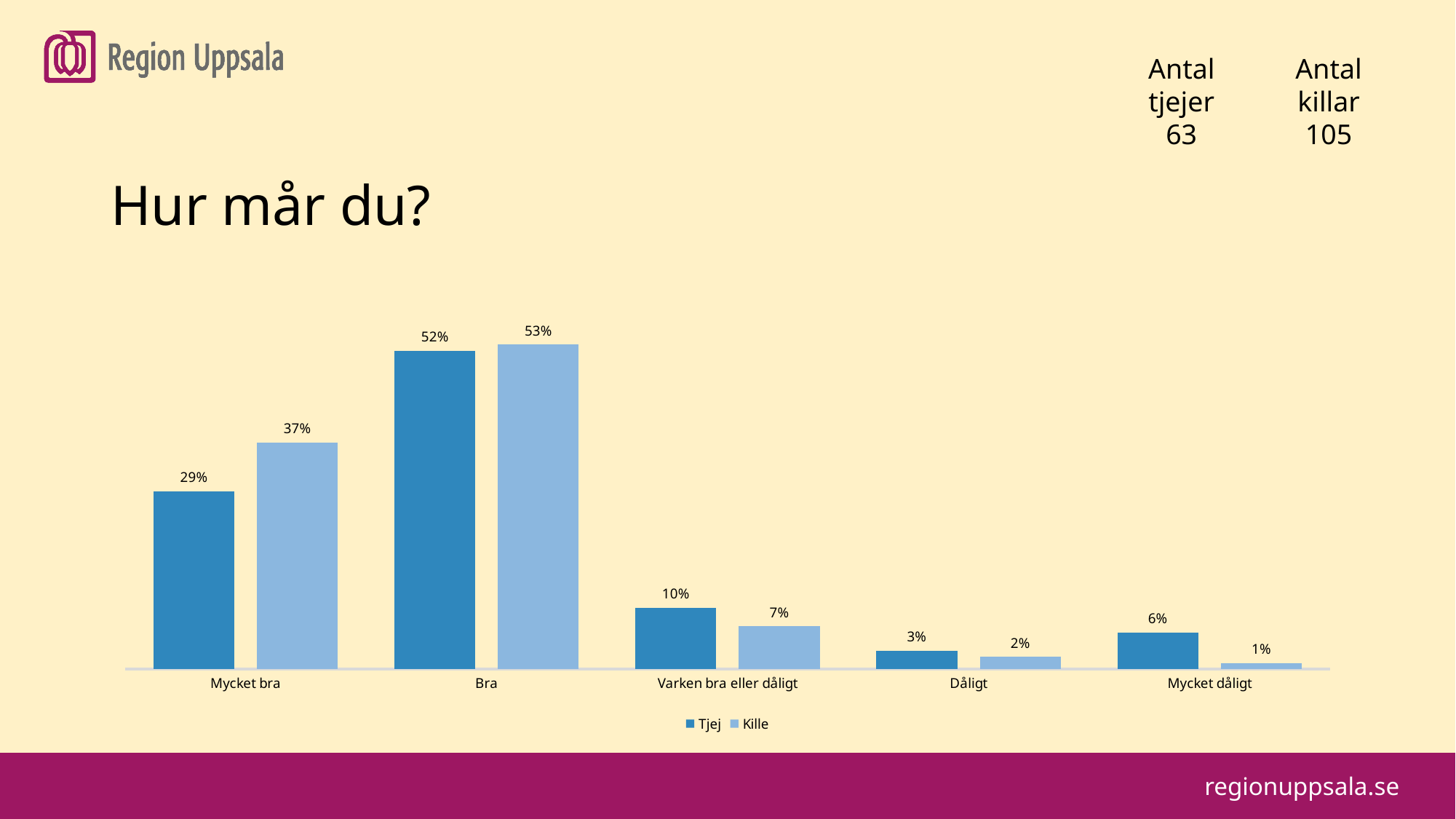
How many categories are shown on the x axis? 5 Which category has the highest value for Tjej? Bra What is the title of the chart? Hur mår du? What is the value for Kille in the Mycket dåligt category? 1% What is the value for Kille in the Bra category? 53% What is the value for Tjej in the Varken bra eller dåligt category? 10% Which category has the lowest value for Kille? Mycket dåligt What kind of chart is shown on the slide? Bar chart What is the value for Tjej in the Mycket bra category? 29% How many series does the legend list? 2 What is the difference between the Kille and Tjej values in the Mycket bra category? 8% Which is larger in the Dåligt category, Tjej or Kille? Tjej